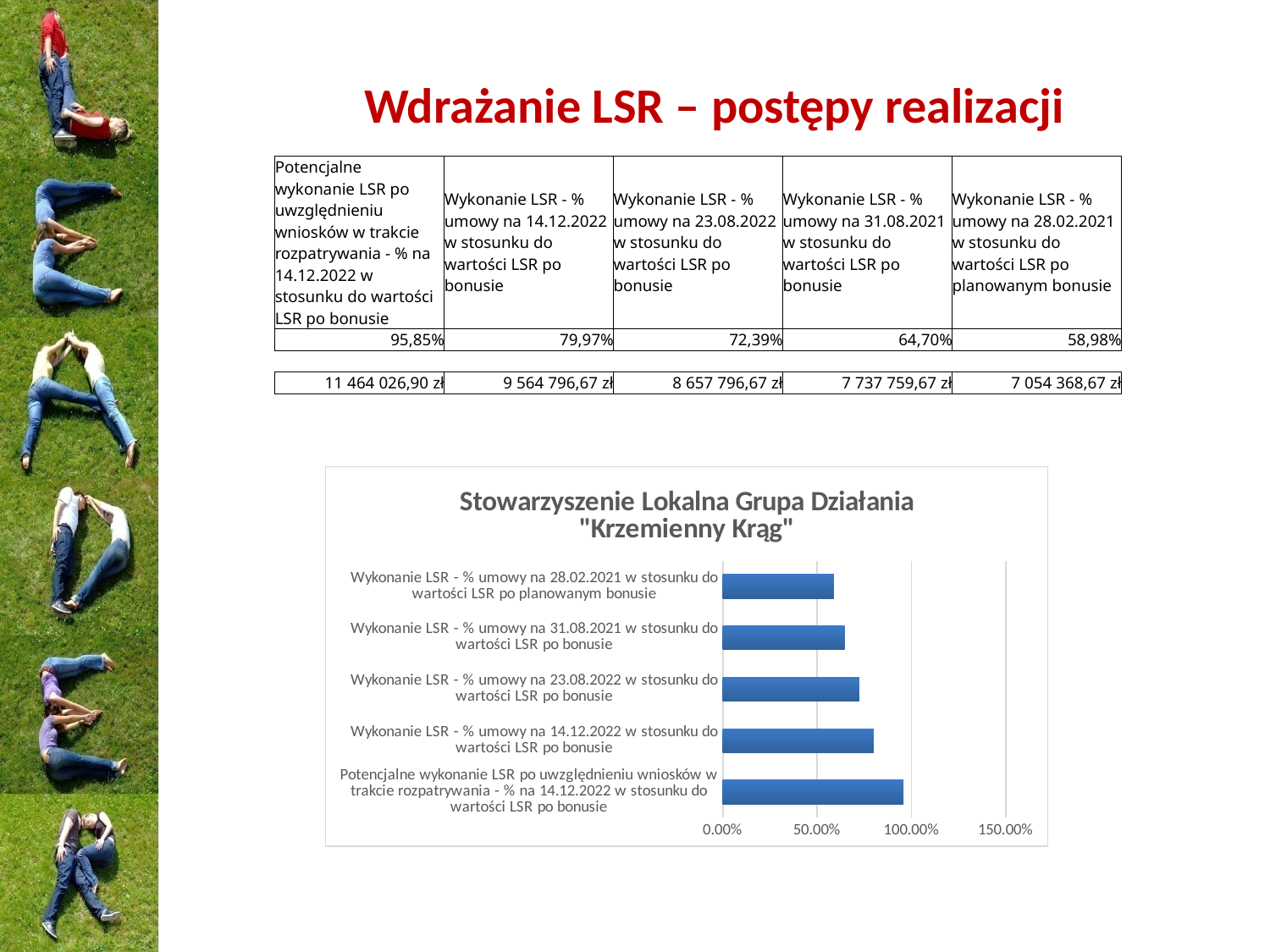
Which is larger: the value for "Wykonanie LSR - % umowy na 14.12.2022 w stosunku do wartości LSR po bonusie" or for "Wykonanie LSR - % umowy na 23.08.2022 w stosunku do wartości LSR po bonusie"? Wykonanie LSR - % umowy na 14.12.2022 w stosunku do wartości LSR po bonusie Which category has the longest bar in the chart? Potencjalne wykonanie LSR po uwzględnieniu wniosków w trakcie rozpatrywania - % na 14.12.2022 w stosunku do wartości LSR po bonusie What is the title of the chart? Stowarzyszenie Lokalna Grupa Działania "Krzemienny Krąg" Reading the bars from top to bottom, do the values increase or decrease? increase Which category has the shortest bar in the chart? Wykonanie LSR - % umowy na 28.02.2021 w stosunku do wartości LSR po planowanym bonusie What colour are the bars in the chart? blue Is the value for "Wykonanie LSR - % umowy na 28.02.2021 w stosunku do wartości LSR po planowanym bonusie" greater or less than 50.00%? greater Is the value for "Wykonanie LSR - % umowy na 14.12.2022 w stosunku do wartości LSR po bonusie" greater or less than 100.00%? less How many categories (bars) does the chart show? 5 What kind of chart is shown on the slide? bar chart Is the value for "Wykonanie LSR - % umowy na 31.08.2021 w stosunku do wartości LSR po bonusie" greater or less than 50.00%? greater